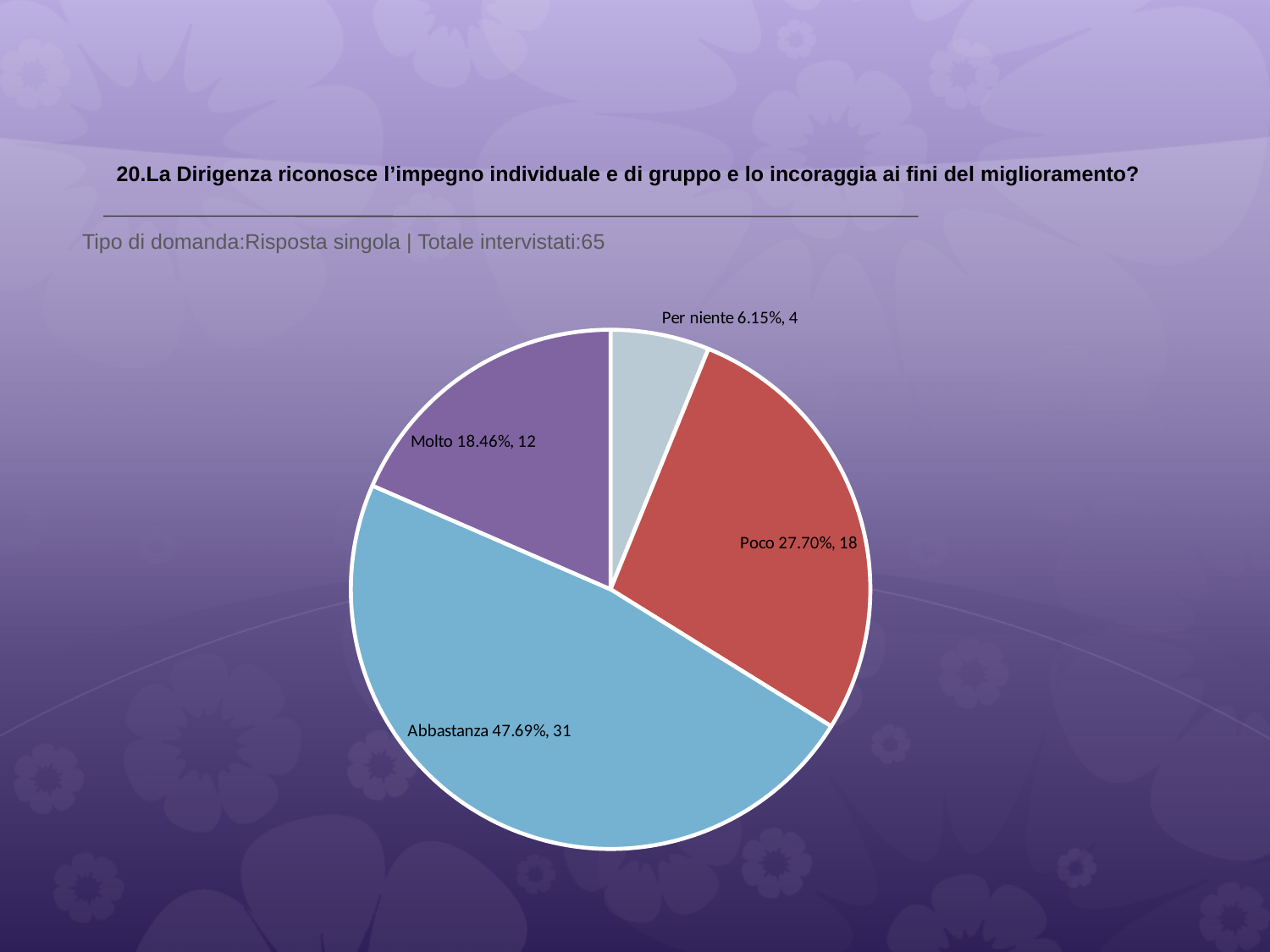
What share of the pie does the 'Molto' slice represent? 18.46% What is the count for the 'Molto' slice? 12 Which has a larger count, 'Molto' or 'Poco'? Poco Which category has the smallest slice? Per niente How many slices does the pie chart have? 4 What is the difference in count between 'Abbastanza' and 'Poco'? 13 What percentage is shown for the 'Per niente' slice? 6.15% What kind of chart is shown on the slide? pie chart What percentage is shown for the 'Poco' slice? 27.70% Which category has the largest slice? Abbastanza What is the count for the 'Abbastanza' slice? 31 What is the total number of respondents stated on the slide? 65